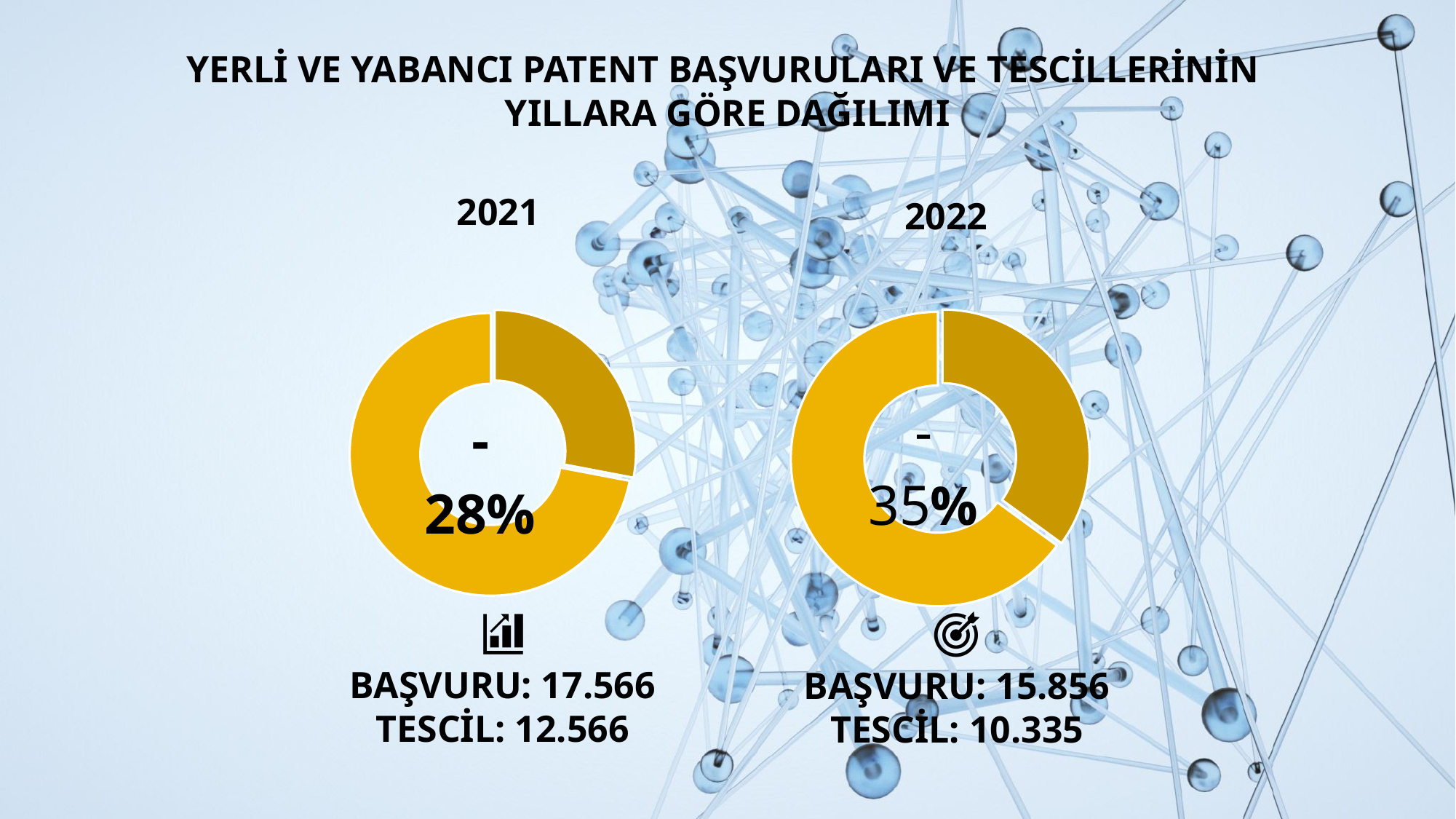
What is the title of the slide containing the two donut charts? YERLİ VE YABANCI PATENT BAŞVURULARI VE TESCİLLERİNİN YILLARA GÖRE DAĞILIMI How many slices does the 2022 donut chart have? 2 How many donut charts are shown on the slide? 2 Which year has the larger BAŞVURU value, 2021 or 2022? 2021 What is the TESCİL value shown under the 2021 chart? 12.566 What is the BAŞVURU value shown under the 2021 chart? 17.566 What percentage is printed in the centre of the 2022 donut chart? 35% What is the BAŞVURU value shown under the 2022 chart? 15.856 What is the TESCİL value shown under the 2022 chart? 10.335 How many slices does the 2021 donut chart have? 2 What kind of chart is used for the 2021 and 2022 figures on the slide? Donut (pie) chart What percentage is printed in the centre of the 2021 donut chart? 28%